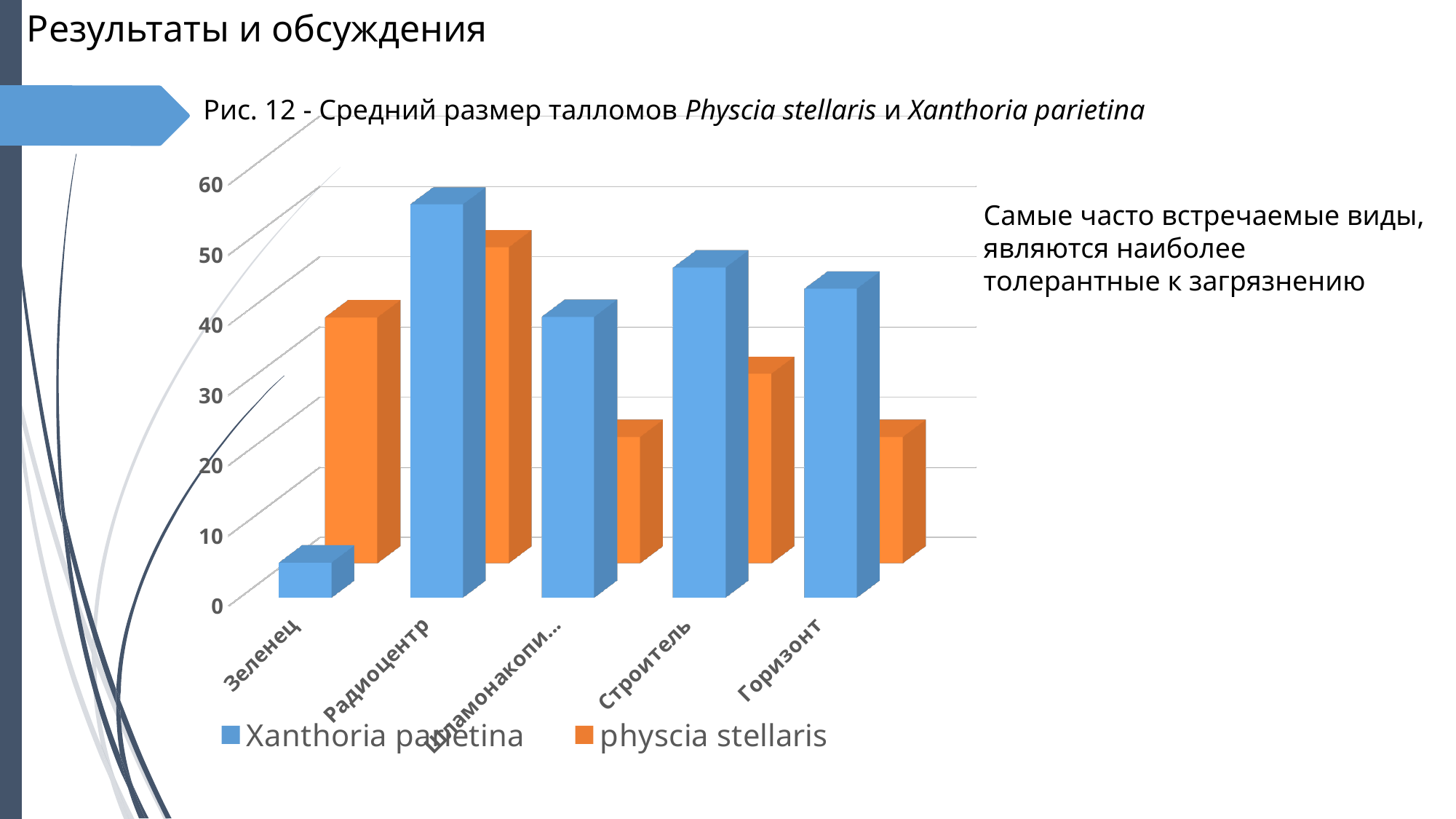
At Зеленец, which series has the larger value, Xanthoria parietina or physcia stellaris? physcia stellaris Is the value for physcia stellaris at Горизонт greater or less than 30? less Which category has the lowest value for Xanthoria parietina? Зеленец Is the value for Xanthoria parietina at Радиоцентр greater or less than 50? greater How many series does the legend list? 2 Which category has the highest value for physcia stellaris? Радиоцентр At Строитель, which series has the larger value, Xanthoria parietina or physcia stellaris? Xanthoria parietina Which category has the highest value for Xanthoria parietina? Радиоцентр Is the value for Xanthoria parietina at Зеленец greater or less than 10? less What kind of chart is shown on the slide? bar chart What colour represents physcia stellaris in the chart? orange How many categories are shown on the x axis? 5